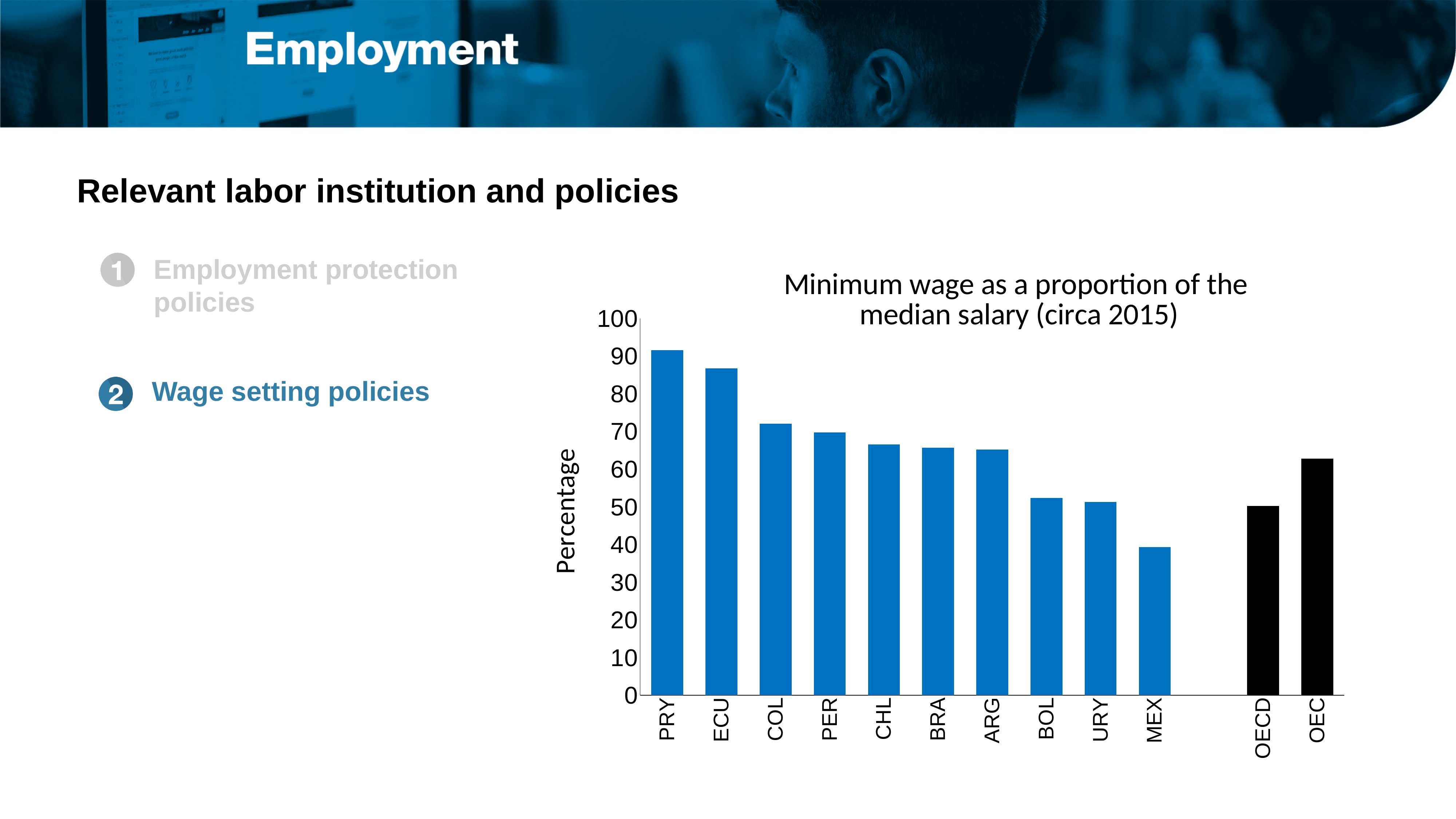
Which category has the highest value in the chart? PRY How many categories are shown on the x axis of the chart? 12 Which is larger, the value for ECU or the value for COL? ECU Is the value for MEX greater or less than 50? less Which is larger, the value for OEC or the value for OECD? OEC What is the label on the vertical axis of the chart? Percentage Do the values of the blue bars rise or fall from PRY to MEX along the x axis? fall What kind of chart is shown on the slide? bar chart Is the value for OEC greater or less than 60? greater What is the title of the chart? Minimum wage as a proportion of the median salary (circa 2015) Which category has the lowest value in the chart? MEX Is the value for PRY greater or less than 80? greater